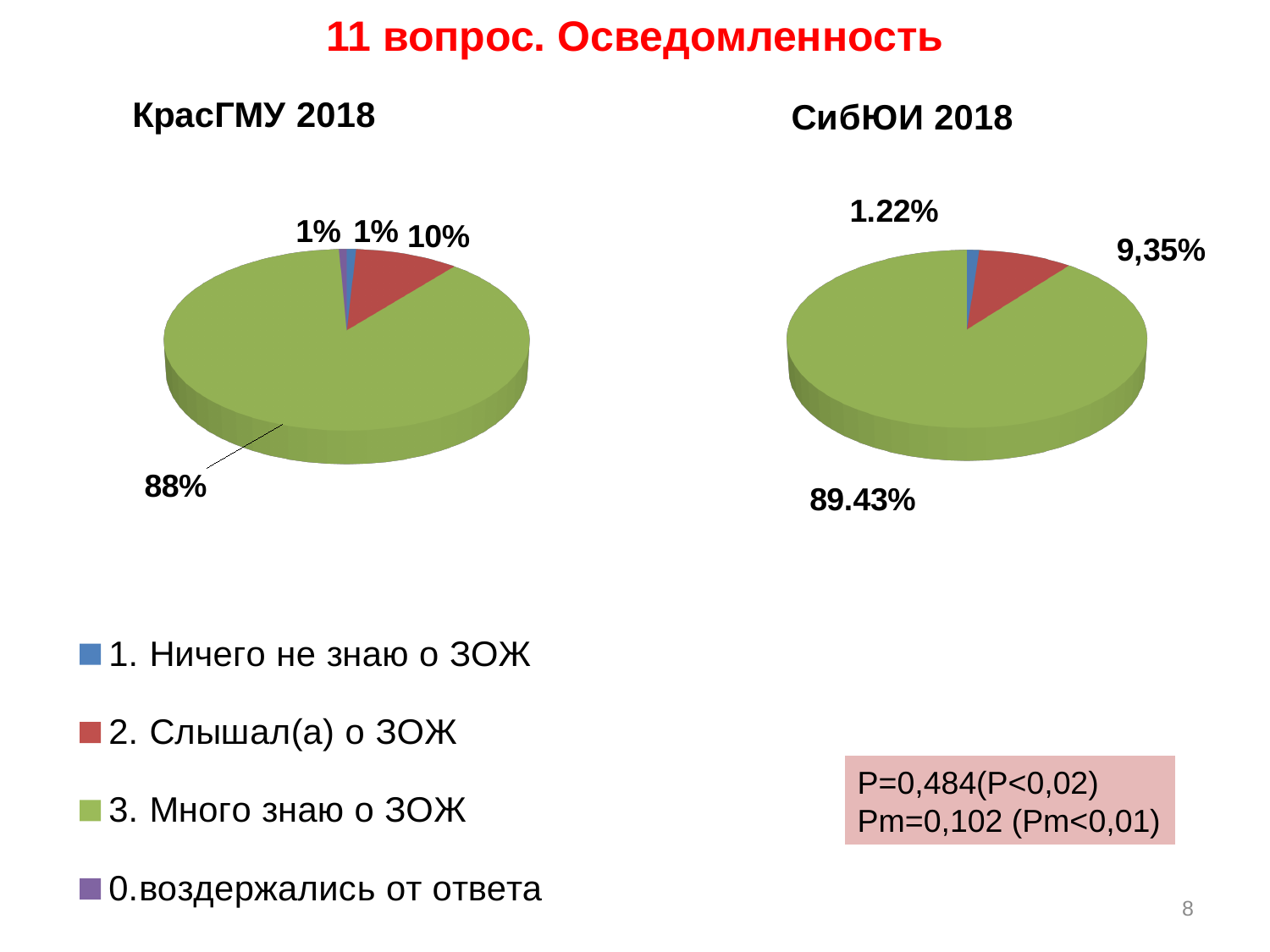
In the СибЮИ 2018 pie chart, what percentage is shown for "3. Много знаю о ЗОЖ"? 89.43% In the КрасГМУ 2018 pie chart, which category has the largest slice? 3. Много знаю о ЗОЖ What type of chart is used for КрасГМУ 2018 and СибЮИ 2018? Pie chart Which chart shows a larger share for "3. Много знаю о ЗОЖ", КрасГМУ 2018 or СибЮИ 2018? СибЮИ 2018 In the КрасГМУ 2018 pie chart, what is the difference between the shares for "3. Много знаю о ЗОЖ" and "2. Слышал(а) о ЗОЖ"? 78 percentage points In the КрасГМУ 2018 pie chart, what percentage is shown for "2. Слышал(а) о ЗОЖ"? 10% In the СибЮИ 2018 pie chart, which category has the smallest slice? 1. Ничего не знаю о ЗОЖ In the СибЮИ 2018 pie chart, what percentage is shown for "2. Слышал(а) о ЗОЖ"? 9,35% How many slices are shown in the СибЮИ 2018 pie chart? 3 In the СибЮИ 2018 pie chart, what percentage is shown for "1. Ничего не знаю о ЗОЖ"? 1.22% In the КрасГМУ 2018 pie chart, what percentage is shown for "3. Много знаю о ЗОЖ"? 88% How many entries does the legend list? 4